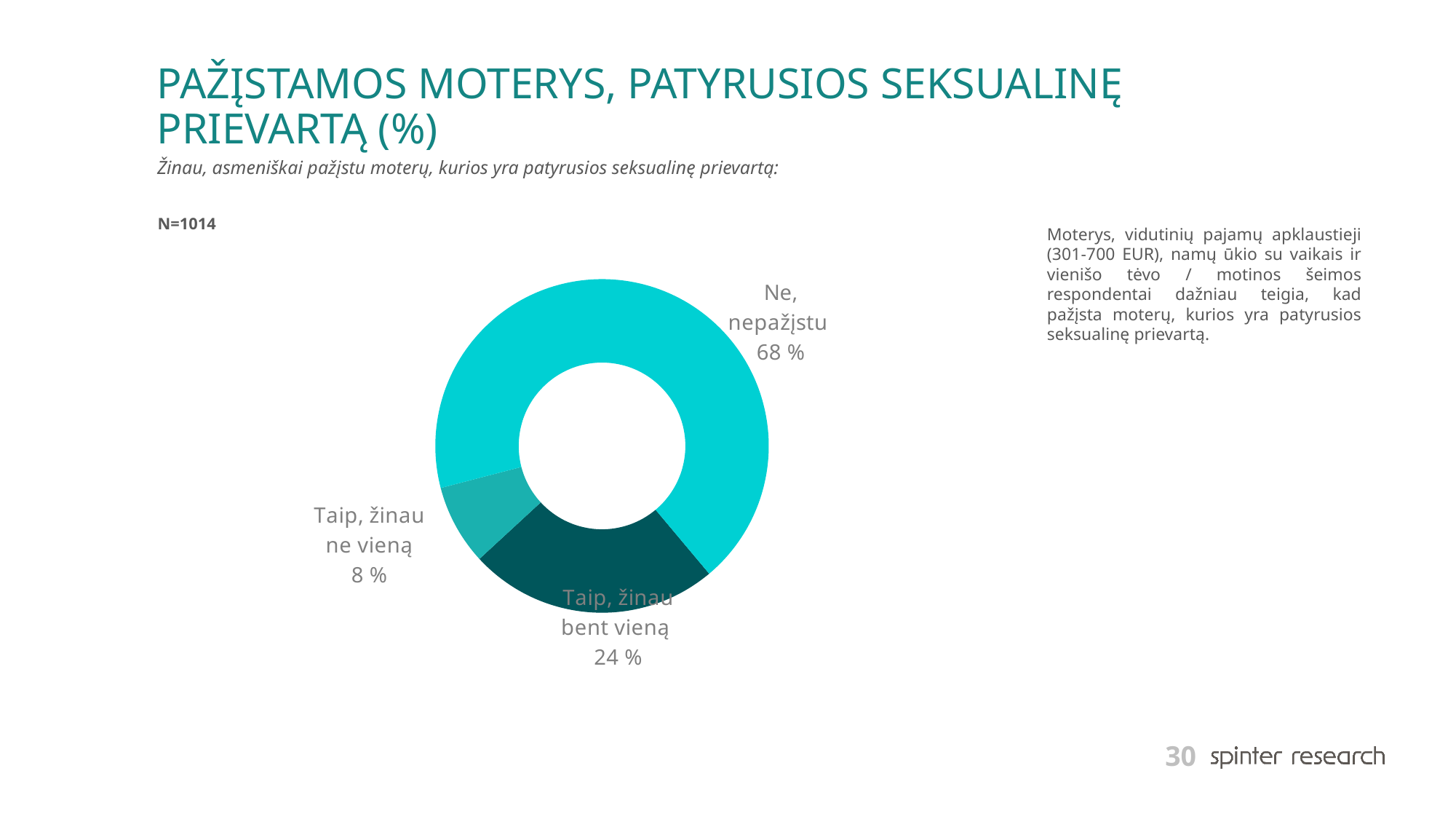
How many categories are shown in the chart? 3 Which category has the smallest share of the chart? Taip, žinau ne vieną What percentage of respondents answered "Taip, žinau bent vieną"? 24 % What kind of chart is shown on the slide? Doughnut (pie) chart What percentage of respondents answered "Taip, žinau ne vieną"? 8 % What is the combined share of the two "Taip" categories? 32 % What is the sample size (N) stated on the slide? N=1014 What percentage of respondents answered "Ne, nepažįstu"? 68 % Which category has the largest share of the chart? Ne, nepažįstu What is the difference in percentage points between "Ne, nepažįstu" and "Taip, žinau bent vieną"? 44 Which is larger: the share for "Taip, žinau bent vieną" or "Taip, žinau ne vieną"? Taip, žinau bent vieną What is the difference in percentage points between "Taip, žinau bent vieną" and "Taip, žinau ne vieną"? 16